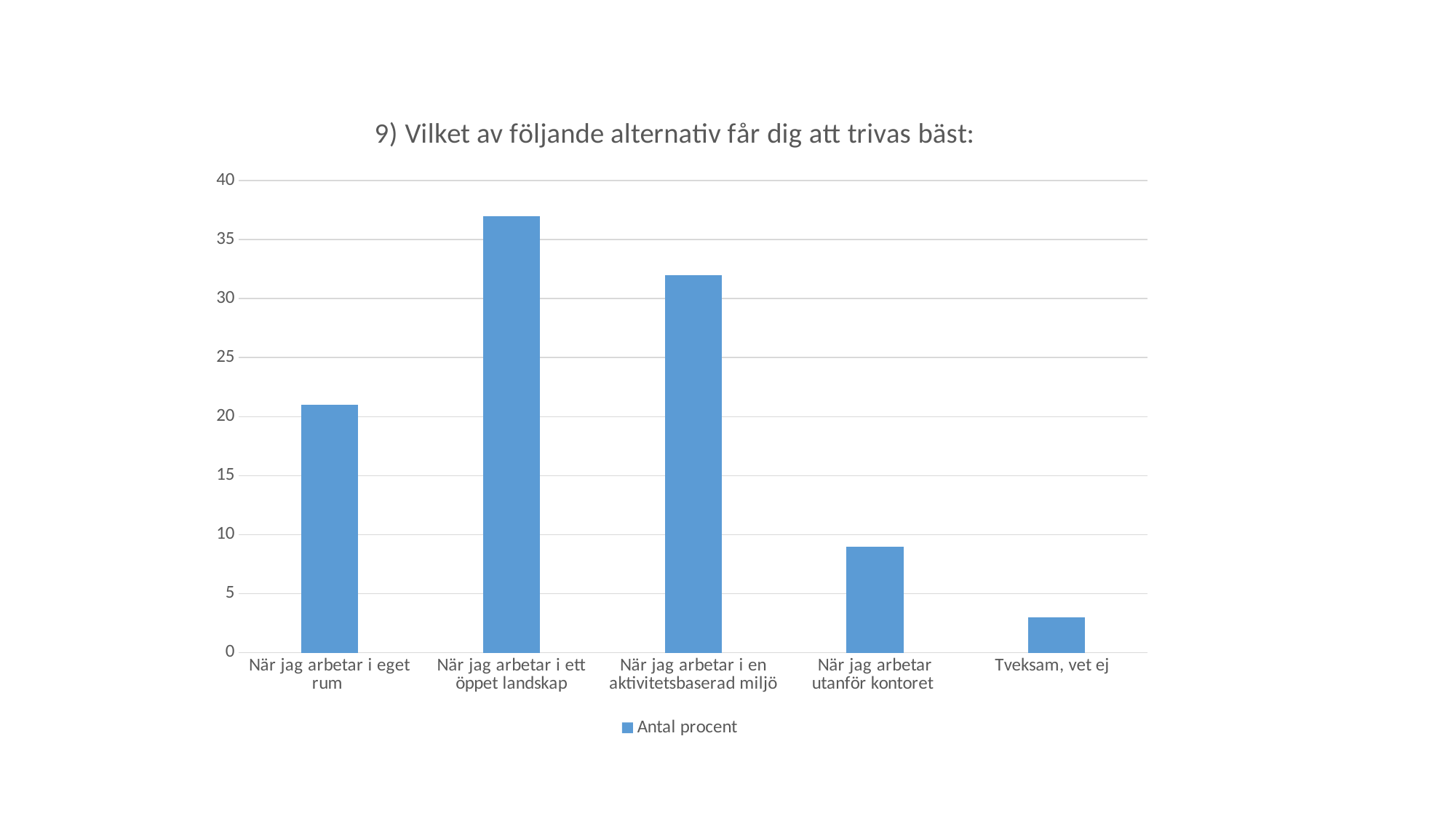
Is the value for 'När jag arbetar utanför kontoret' greater or less than 10? less What kind of chart is shown on the slide? bar chart How many categories are shown on the x axis? 5 Is the value for 'Tveksam, vet ej' greater or less than 5? less Is the value for 'När jag arbetar i eget rum' greater or less than 20? greater What is the name of the series shown in the legend? Antal procent How many series does the legend list? 1 Which category has the highest value? När jag arbetar i ett öppet landskap Which category has the lowest value? Tveksam, vet ej Which is larger, the value for 'När jag arbetar i eget rum' or the value for 'När jag arbetar i en aktivitetsbaserad miljö'? När jag arbetar i en aktivitetsbaserad miljö